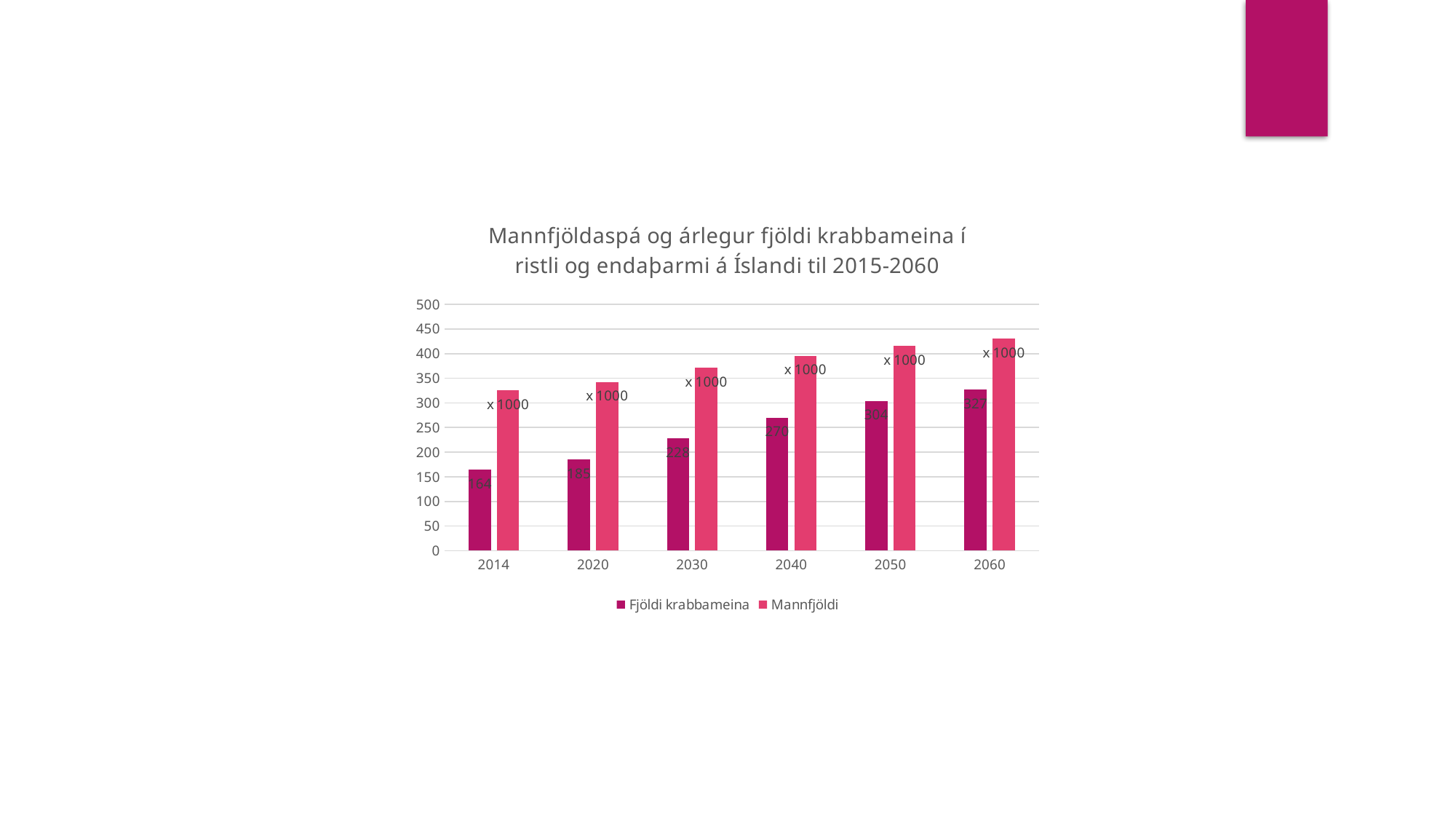
What is the value for Fjöldi krabbameina in 2060? 327 Is the value for Mannfjöldi in 2060 greater or less than 400? greater What is the difference between the Fjöldi krabbameina values for 2060 and 2014? 163 Which year has the highest value for Fjöldi krabbameina? 2060 Do the Fjöldi krabbameina values rise or fall from 2014 to 2060? rise Which is larger, the Fjöldi krabbameina value for 2030 or for 2050? 2050 How many series does the legend list? 2 Which year has the lowest value for Fjöldi krabbameina? 2014 How many years are shown on the x axis? 6 What is the value for Fjöldi krabbameina in 2014? 164 Is the value for Mannfjöldi in 2014 greater or less than 350? less What is the value for Fjöldi krabbameina in 2040? 270